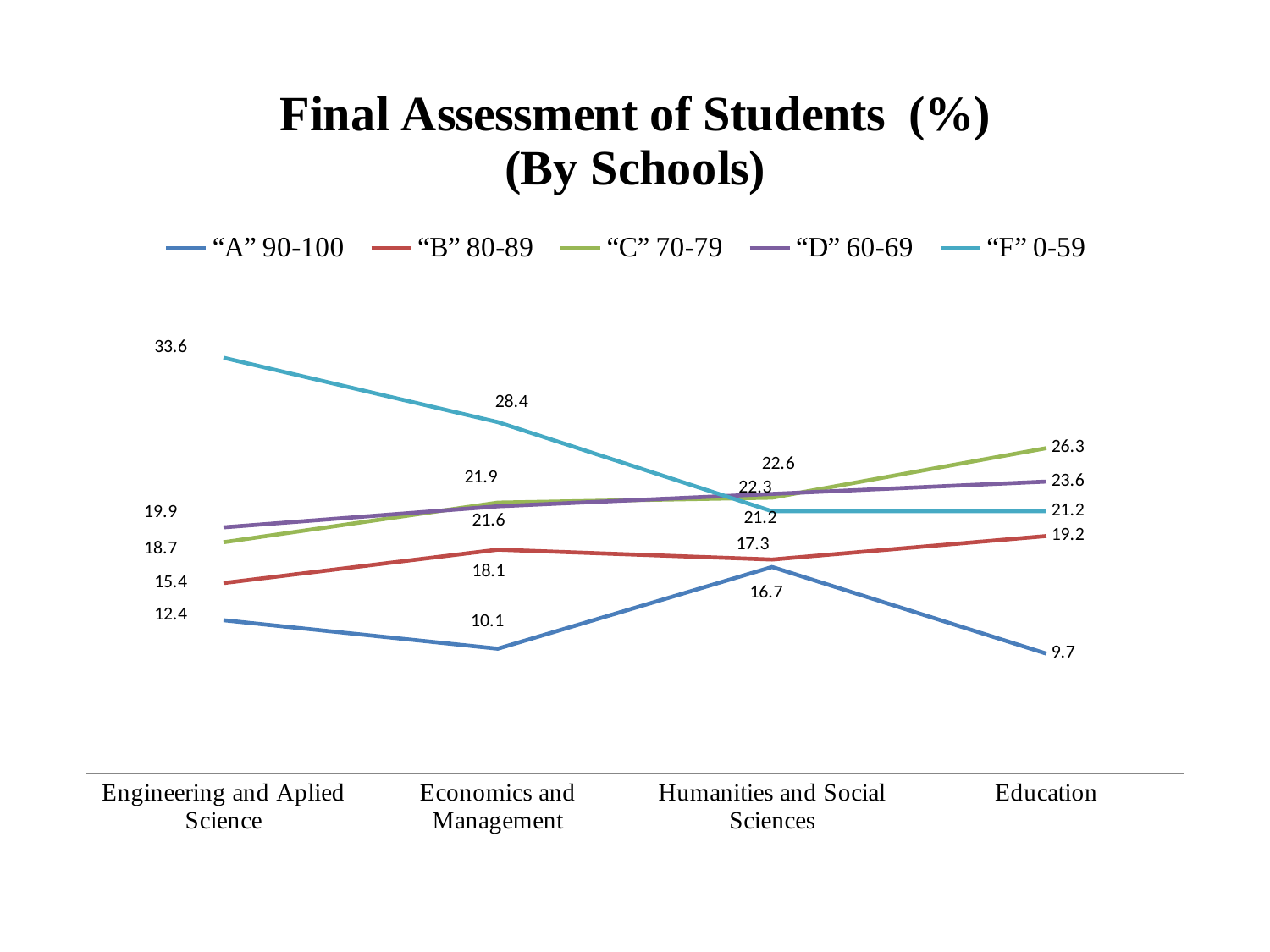
How many series does the legend list? 5 How many schools are shown along the x axis? 4 What kind of chart is shown on the slide? line chart Which school has the lowest value for "A" 90-100? Education What is the difference between the "F" 0-59 value for Engineering and Aplied Science and for Education? 12.4 Does the "F" 0-59 line rise or fall from Engineering and Aplied Science to Economics and Management? fall Which is larger: the "A" 90-100 value for Humanities and Social Sciences or for Economics and Management? Humanities and Social Sciences What is the value of "F" 0-59 for Engineering and Aplied Science? 33.6 What is the title of the chart? Final Assessment of Students (%) (By Schools) What is the value of "A" 90-100 for Education? 9.7 Which school has the highest value for "F" 0-59? Engineering and Aplied Science What is the value of "B" 80-89 for Economics and Management? 18.1